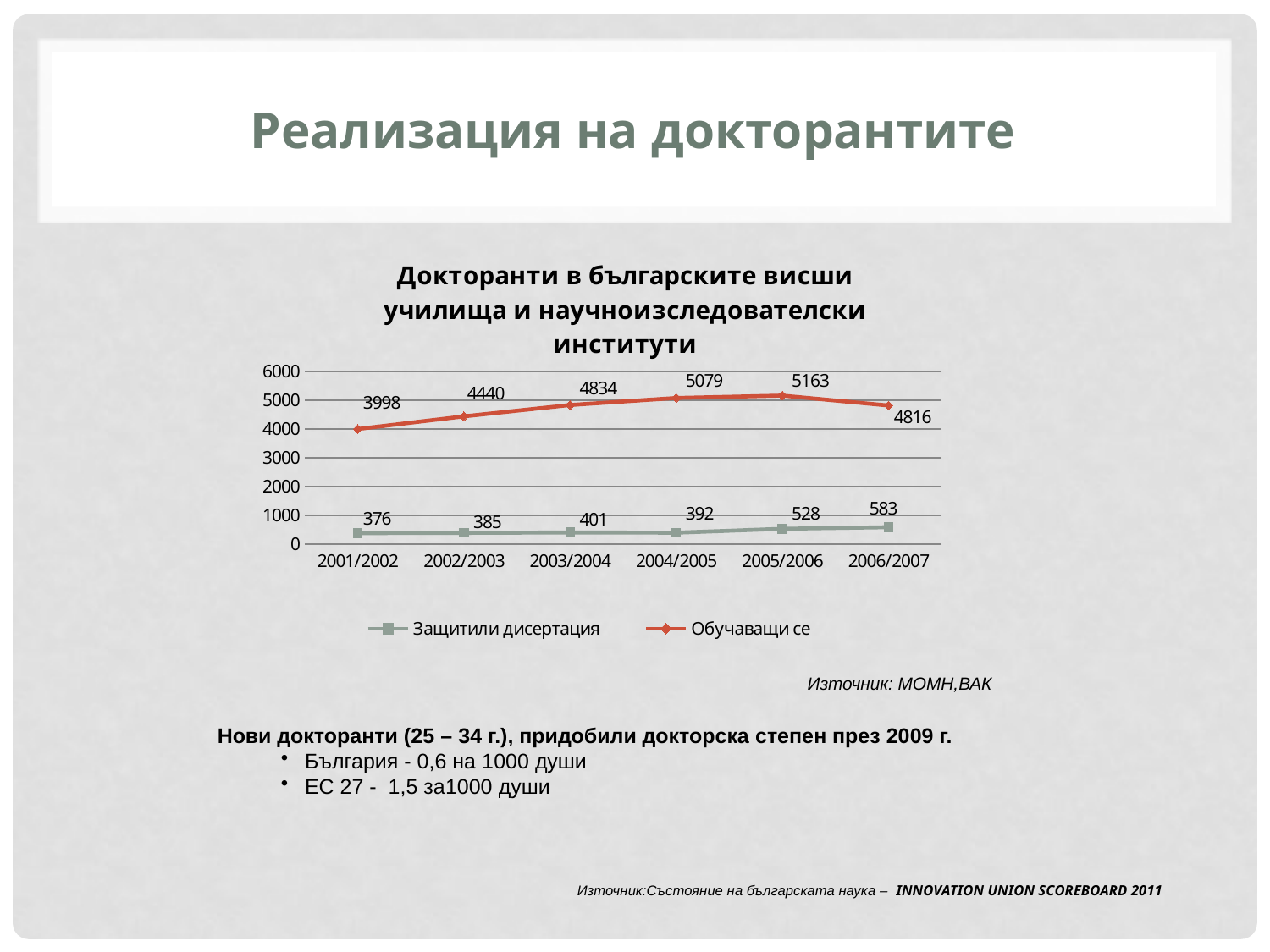
What is the difference between Обучаващи се in 2005/2006 and 2006/2007? 347 What kind of chart is shown on the slide? line chart What is the difference between Защитили дисертация in 2006/2007 and 2005/2006? 55 What is the value for Обучаващи се in 2006/2007? 4816 In which year is Обучаващи се highest? 2005/2006 Does Защитили дисертация rise or fall from 2004/2005 to 2006/2007? rise Which is larger: Защитили дисертация in 2003/2004 or in 2004/2005? 2003/2004 In which year is Защитили дисертация lowest? 2001/2002 What is the value for Обучаващи се in 2005/2006? 5163 What is the value for Защитили дисертация in 2001/2002? 376 How many academic years are shown on the x axis? 6 How many series does the legend list? 2